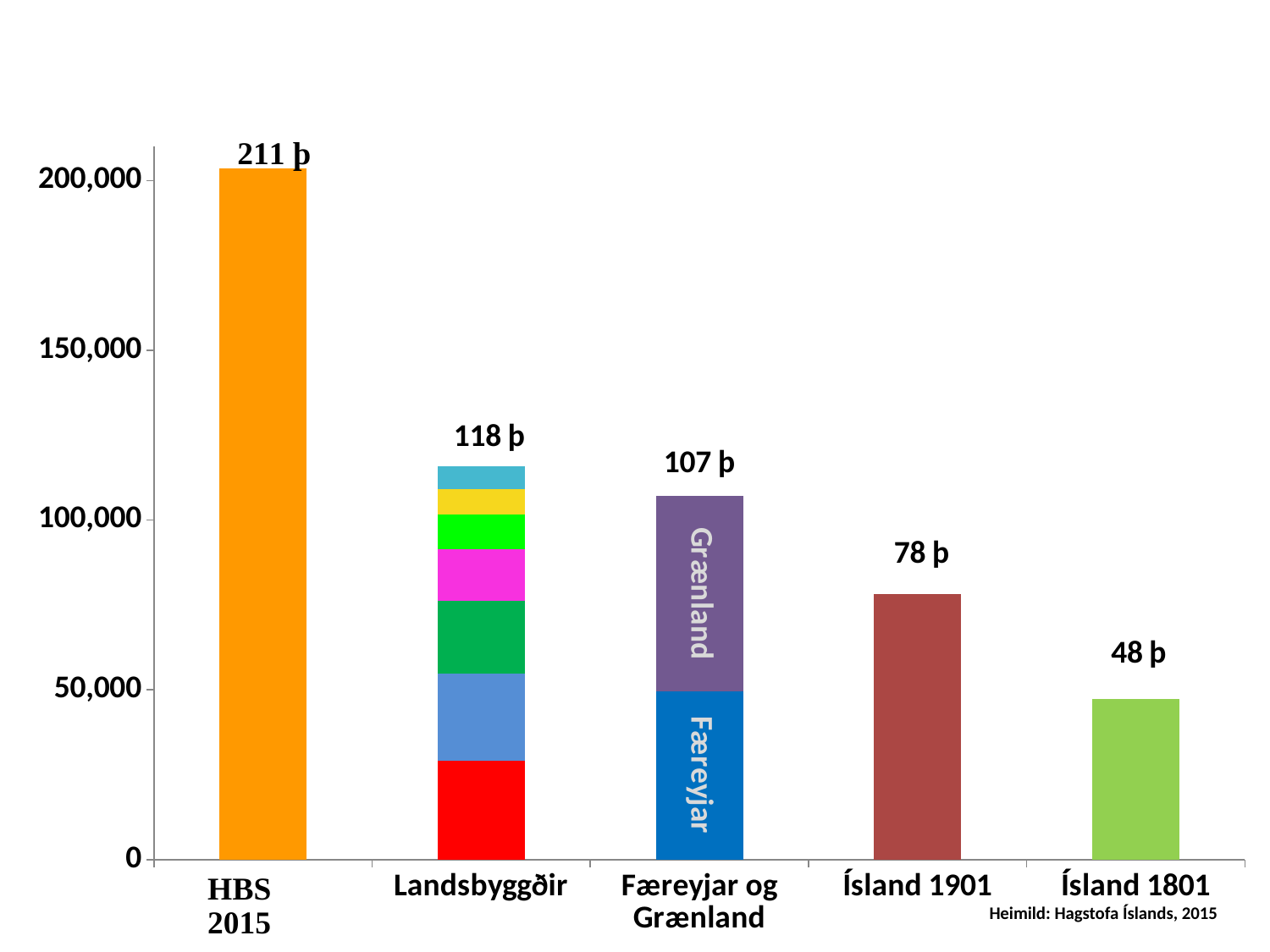
What is the value for Ísland 1801? 48 þ What is the value for Færeyjar og Grænland? 107 þ What is the value for HBS 2015? 211 þ Is the value for Ísland 1901 greater or less than 50,000? greater Which category has the highest value? HBS 2015 What is the difference between the values for Ísland 1901 and Ísland 1801? 30 þ Which category has the lowest value? Ísland 1801 What kind of chart is shown on the slide? bar chart Which is larger, the value for Landsbyggðir or the value for Ísland 1901? Landsbyggðir How many categories are shown on the x axis? 5 What is the difference between the values for HBS 2015 and Landsbyggðir? 93 þ What is the value for Landsbyggðir? 118 þ